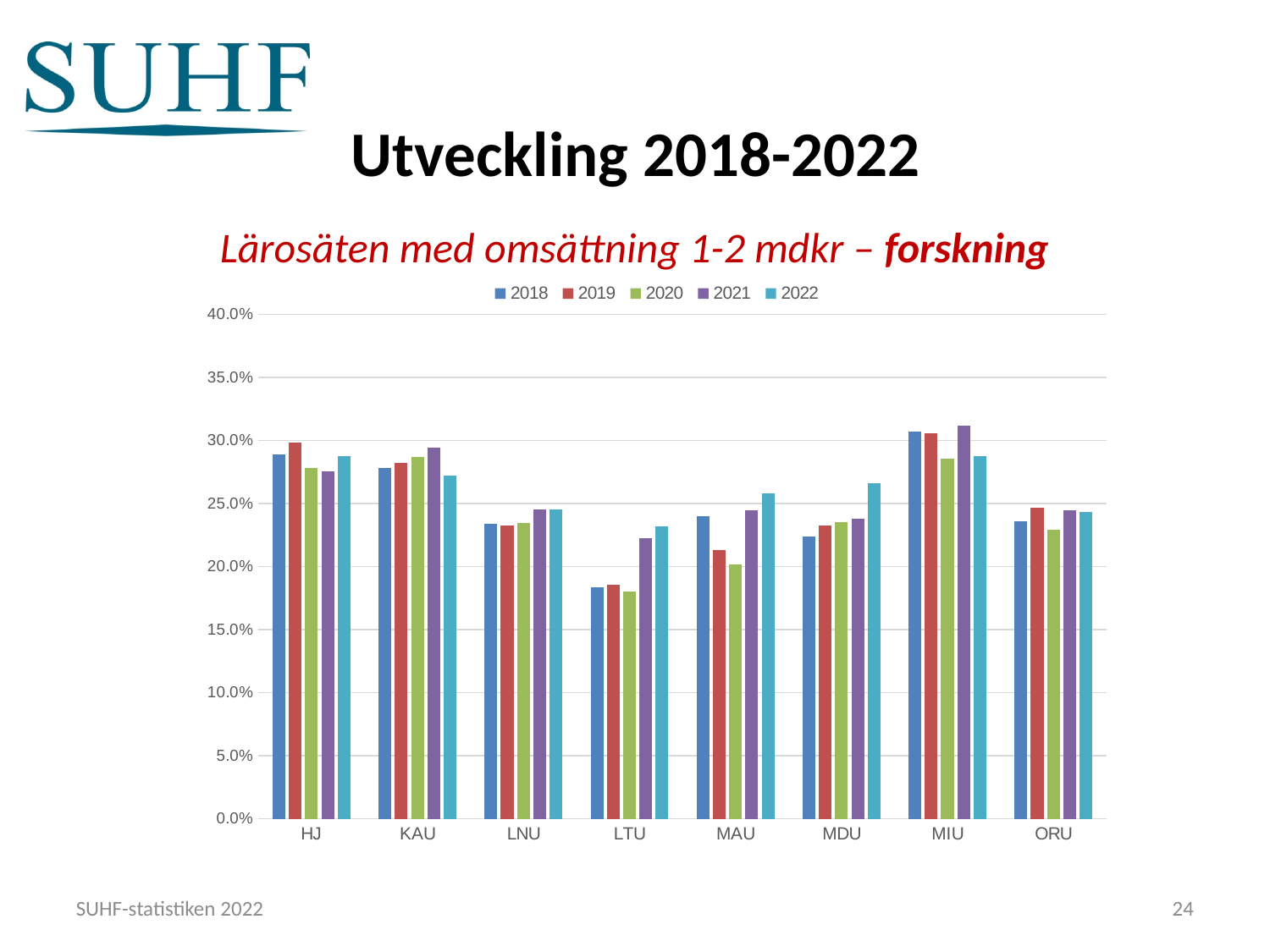
For MDU, do the values rise or fall from 2018 to 2022? rise What kind of chart is shown on the slide? bar chart Is the 2020 value for ORU greater or less than 25.0%? less Is the 2018 value for LTU greater or less than 20.0%? less Is the 2021 value for MIU greater or less than 30.0%? greater How many institutions (categories) are shown on the x axis of the chart? 8 For LTU, which is larger: the 2020 value or the 2021 value? 2021 How many series does the chart's legend list? 5 Which years are listed in the chart's legend? 2018, 2019, 2020, 2021, 2022 Which institution has the highest bar in the chart? MIU Which institution has the lowest bar in the chart? LTU